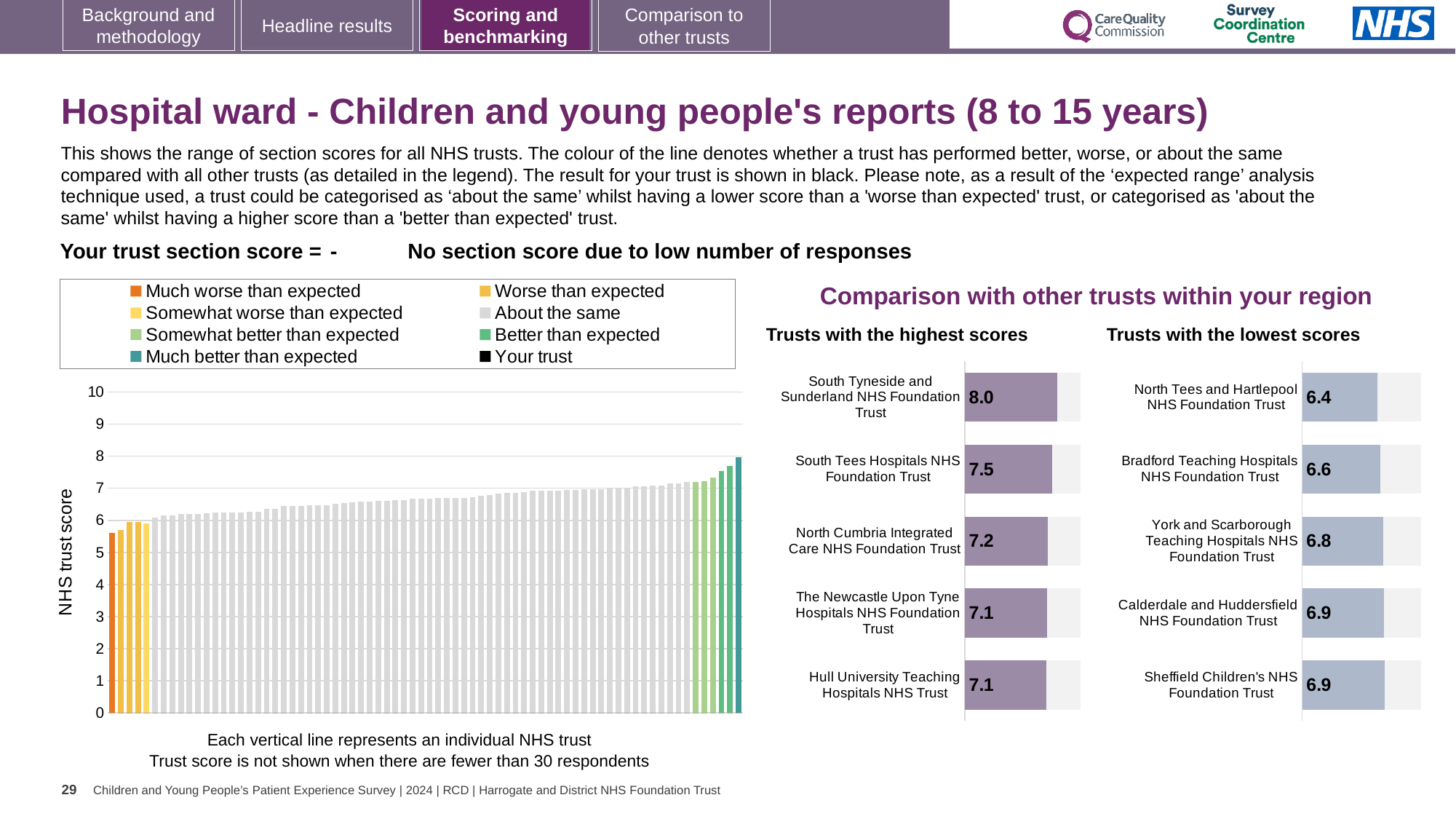
In the 'Trusts with the lowest scores' chart, what is the score for North Tees and Hartlepool NHS Foundation Trust? 6.4 How many entries does the legend above the large chart on the left list? 8 In the 'Trusts with the highest scores' chart, what is the difference between the scores of South Tyneside and Sunderland NHS Foundation Trust and South Tees Hospitals NHS Foundation Trust? 0.5 In the 'Trusts with the lowest scores' chart, what is the difference between the scores of York and Scarborough Teaching Hospitals NHS Foundation Trust and Bradford Teaching Hospitals NHS Foundation Trust? 0.2 What kind of chart is the large chart on the left showing NHS trust scores? Bar chart How many trusts are listed in the 'Trusts with the lowest scores' chart? 5 In the 'Trusts with the highest scores' chart, what is the score for South Tyneside and Sunderland NHS Foundation Trust? 8.0 In the 'Trusts with the highest scores' chart, which trust has the highest score? South Tyneside and Sunderland NHS Foundation Trust In the large chart on the left, do the trust scores rise or fall from left to right? Rise In the 'Trusts with the lowest scores' chart, what score is shown for Sheffield Children's NHS Foundation Trust? 6.9 In the 'Trusts with the lowest scores' chart, which trust has the lowest score? North Tees and Hartlepool NHS Foundation Trust In the 'Trusts with the highest scores' chart, which has a higher score: North Cumbria Integrated Care NHS Foundation Trust or Hull University Teaching Hospitals NHS Trust? North Cumbria Integrated Care NHS Foundation Trust